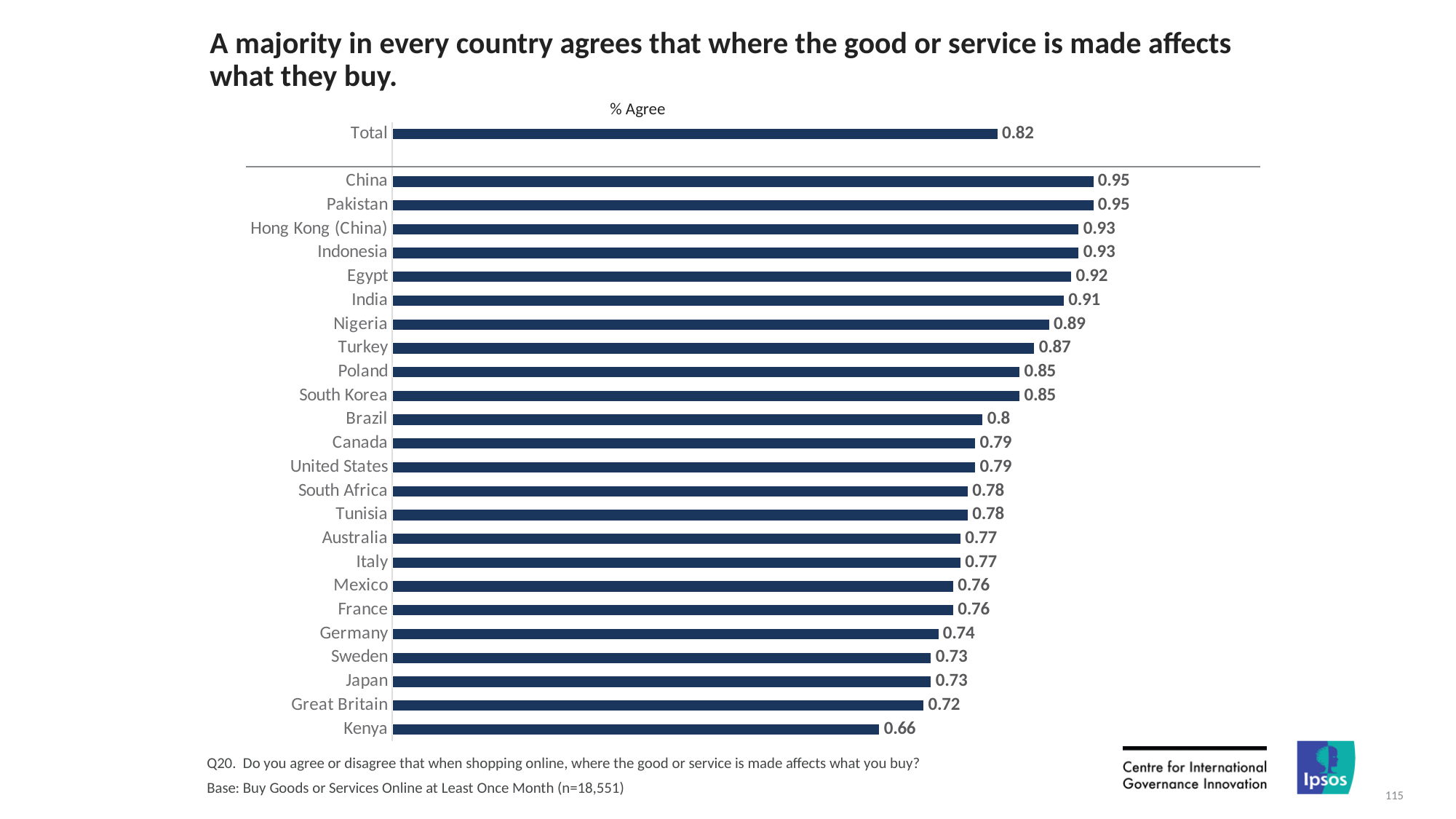
Which country has the lowest value? Kenya Which is larger, the value for Japan or the value for India? India What kind of chart is shown on the slide? Bar chart What is the difference between the values for China and Kenya? 0.29 What is the value for Kenya? 0.66 What is the difference between the values for Nigeria and Brazil? 0.09 What is the label shown above the chart? % Agree What is the value for Total? 0.82 Which is larger, the value for Turkey or the value for Canada? Turkey What is the value for Egypt? 0.92 What is the value for Germany? 0.74 How many countries are listed below the Total bar? 24